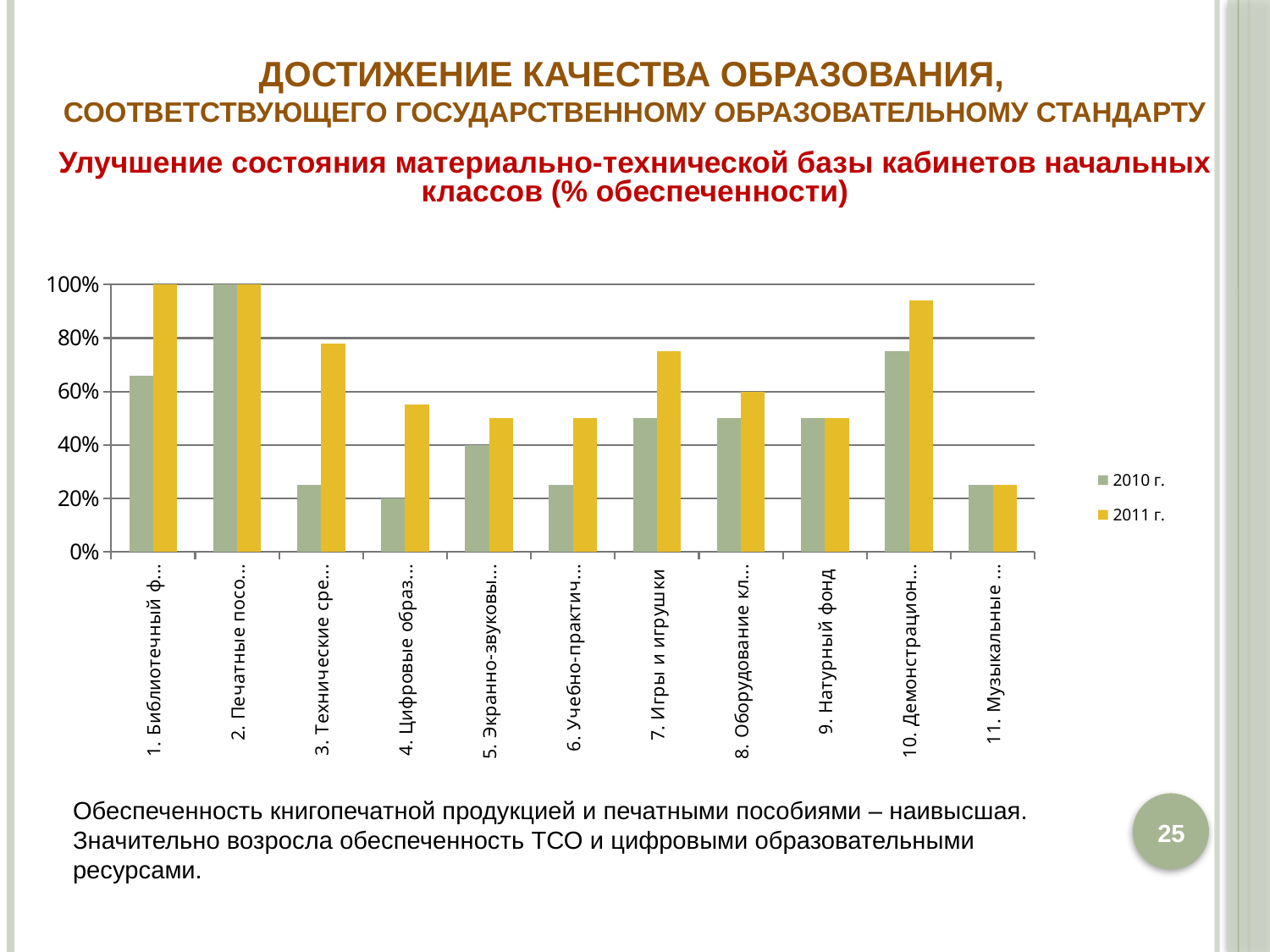
For '7. Игры и игрушки', which is larger: the 2010 г. value or the 2011 г. value? 2011 г. How many categories are plotted along the x axis? 11 Is the 2010 г. value for '9. Натурный фонд' greater or less than 60%? less What kind of chart is shown on the slide? bar chart Is the 2011 г. value for '7. Игры и игрушки' greater or less than 60%? greater What are the two legend entries? 2010 г. and 2011 г. What is the 2010 г. value for category 4 (Цифровые образ...)? 20% What is the 2011 г. value for category 2 (Печатные посо...)? 100% Which is larger: the 2011 г. value for '7. Игры и игрушки' or the 2011 г. value for '9. Натурный фонд'? 7. Игры и игрушки Which category has the highest 2010 г. value? category 2 (Печатные посо...) How many series does the legend list? 2 Which category has the lowest 2010 г. value? category 4 (Цифровые образ...)